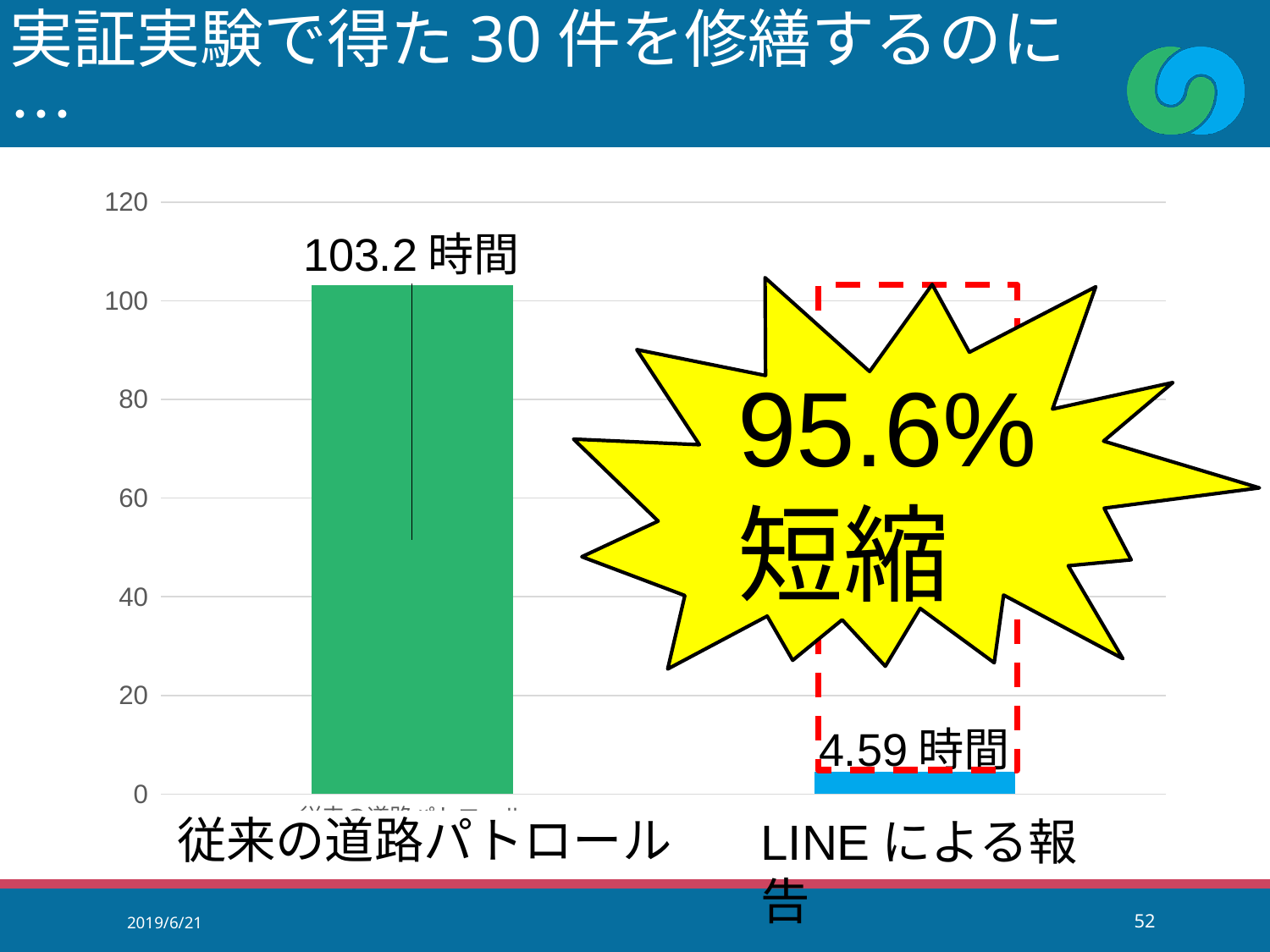
Which category has the highest value? 従来の道路パトロール Is the value for 従来の道路パトロール greater or less than 100? greater What is the value for 従来の道路パトロール? 103.2 時間 What is the difference between the value for 従来の道路パトロール and the value for LINE による報告? 98.61 時間 How many categories are shown in the chart? 2 What kind of chart is shown on the slide? bar chart Is the value for LINE による報告 greater or less than 20? less Which category has the lowest value? LINE による報告 What is the highest value shown on the vertical axis? 120 Which is larger, the value for 従来の道路パトロール or the value for LINE による報告? 従来の道路パトロール What percentage reduction does the starburst callout on the chart state? 95.6% What is the value for LINE による報告? 4.59 時間